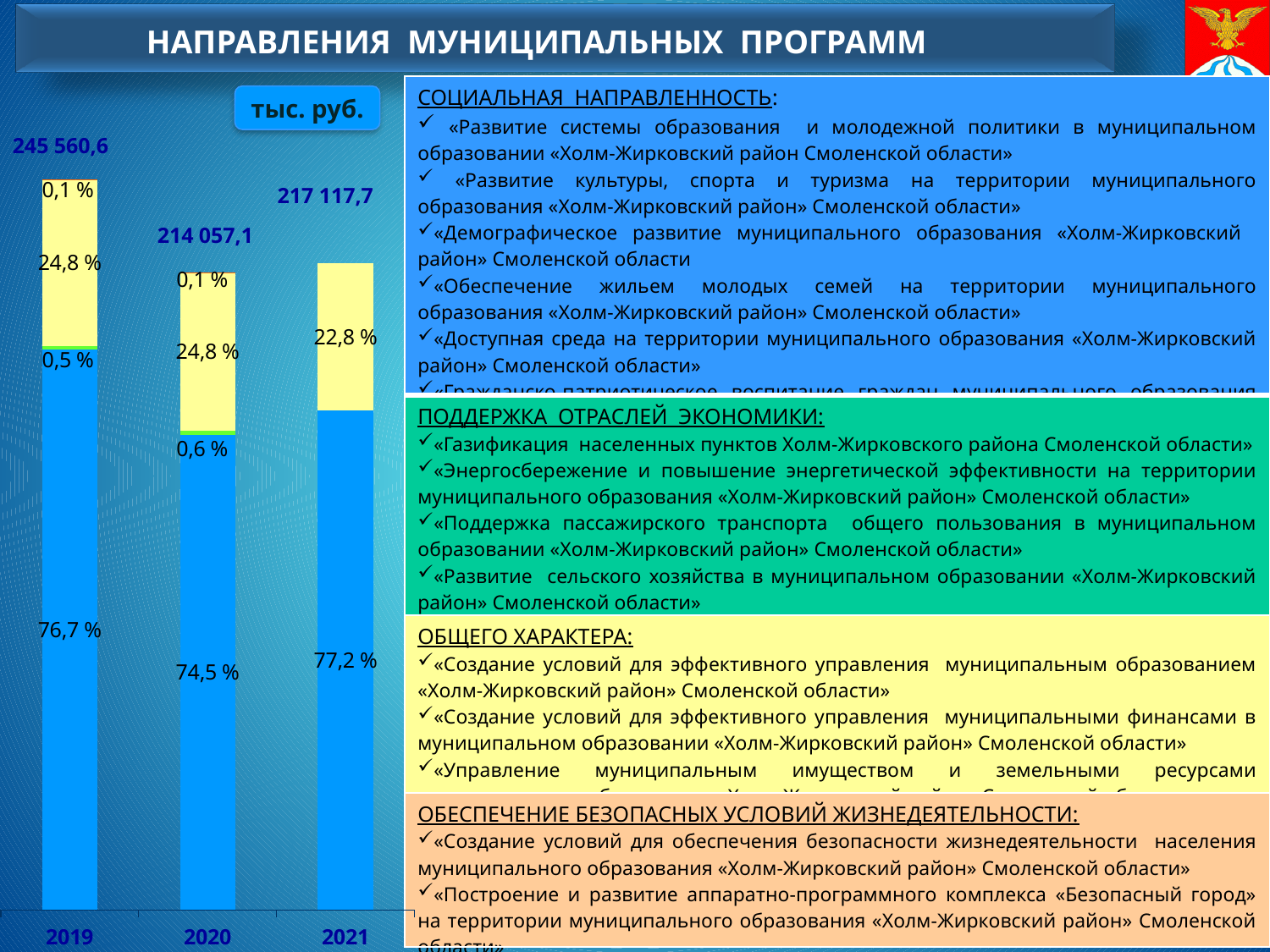
What type of chart is shown on the left of the slide? stacked bar chart What percentage is labelled on the blue (bottom) segment of the 2020 bar? 74,5 % What percentage is labelled on the blue (bottom) segment of the 2021 bar? 77,2 % What is the total value labelled above the 2019 bar? 245 560,6 Which year has the highest total value on the chart? 2019 How many years (bars) are shown on the chart? 3 What unit is shown in the box above the chart? тыс. руб. What is the total value labelled above the 2021 bar? 217 117,7 Which is larger: the total for 2020 or the total for 2021? 2021 What percentage is labelled on the yellow segment of the 2021 bar? 22,8 % Which year has the lowest total value on the chart? 2020 What is the total value labelled above the 2020 bar? 214 057,1